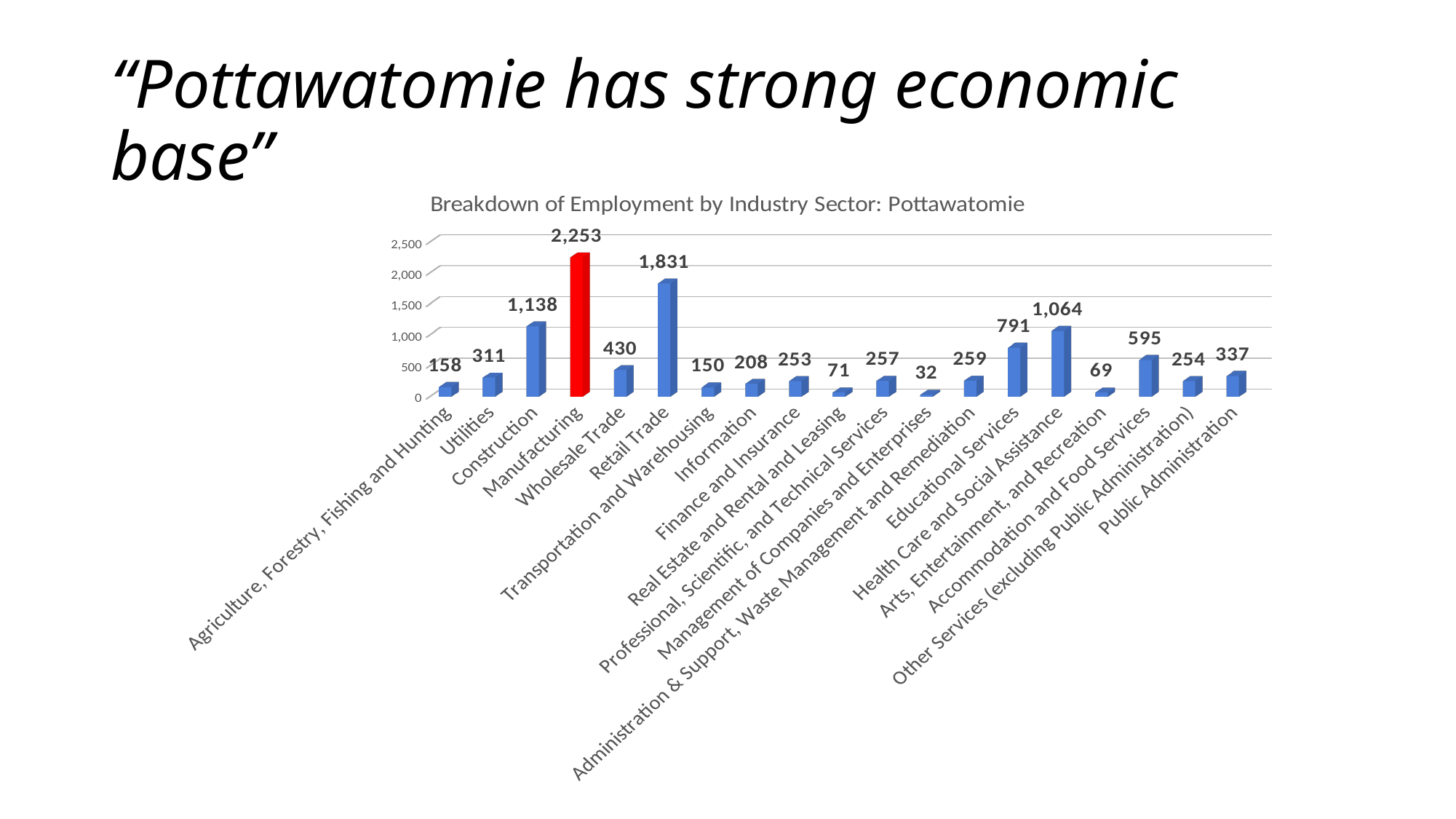
Which is larger, the value for Construction or the value for Health Care and Social Assistance? Construction What is the value for Retail Trade? 1,831 Which industry sector has the highest value? Manufacturing Which industry sector has the lowest value? Management of Companies and Enterprises What is the value for Accommodation and Food Services? 595 What kind of chart is shown on the slide? Bar chart What is the value for Manufacturing? 2,253 What is the value for Health Care and Social Assistance? 1,064 What is the difference between the values for Manufacturing and Retail Trade? 422 Which bar is coloured red instead of blue? Manufacturing Is the value for Educational Services greater or less than 500? greater How many industry sectors are shown on the x axis? 19